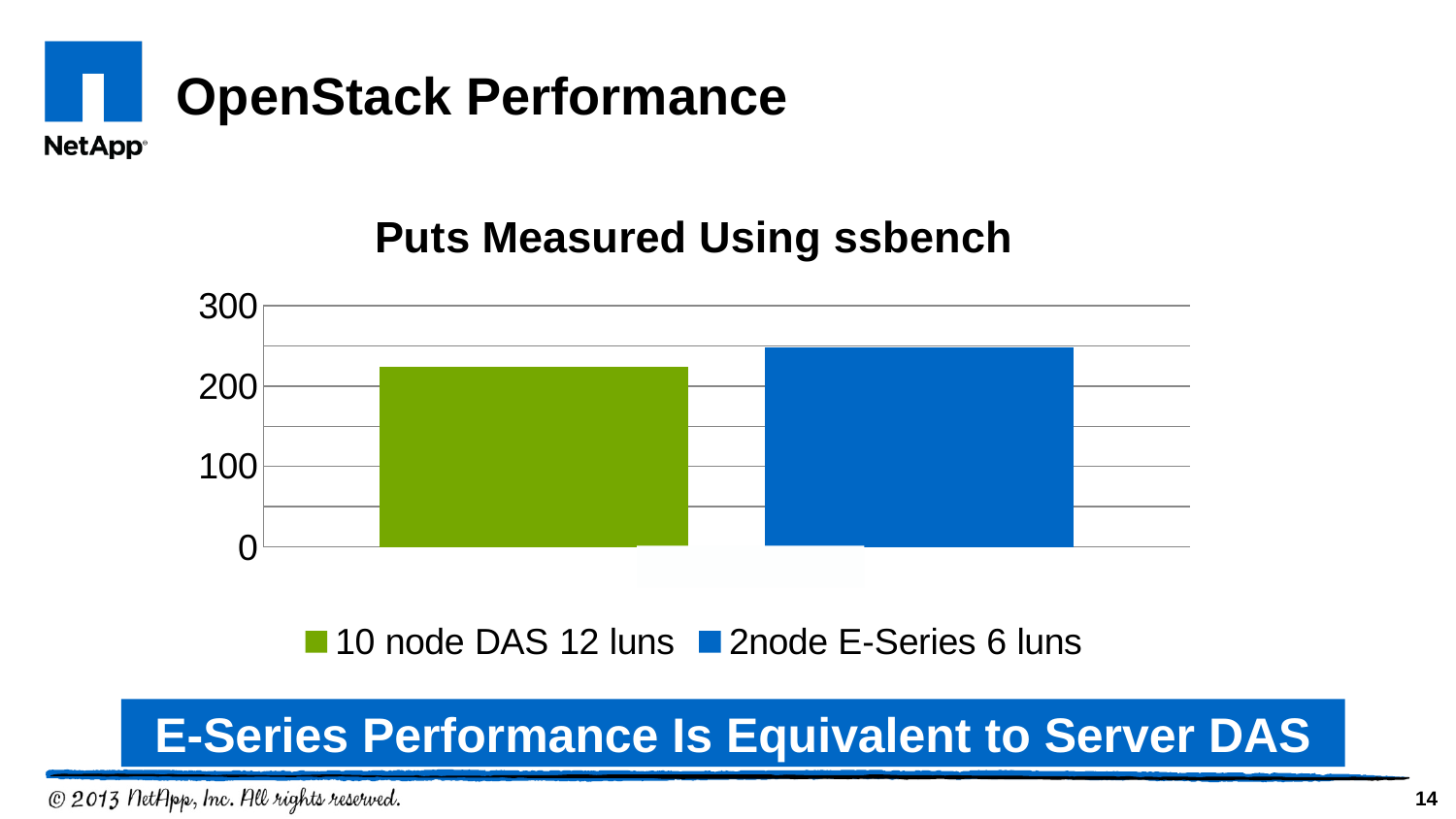
What is the title of the chart? Puts Measured Using ssbench How many bars are plotted in the chart? 2 Which series has the shortest bar in the chart? 10 node DAS 12 luns Which is larger, the value for 10 node DAS 12 luns or the value for 2node E-Series 6 luns? 2node E-Series 6 luns How many series does the chart legend list? 2 What colour is the bar for 2node E-Series 6 luns? blue Which series has the tallest bar in the chart? 2node E-Series 6 luns Is the value for 2node E-Series 6 luns greater or less than 300? less Is the value for 10 node DAS 12 luns greater or less than 100? greater What kind of chart is shown on the slide? bar chart Is the value for 2node E-Series 6 luns greater or less than 200? greater